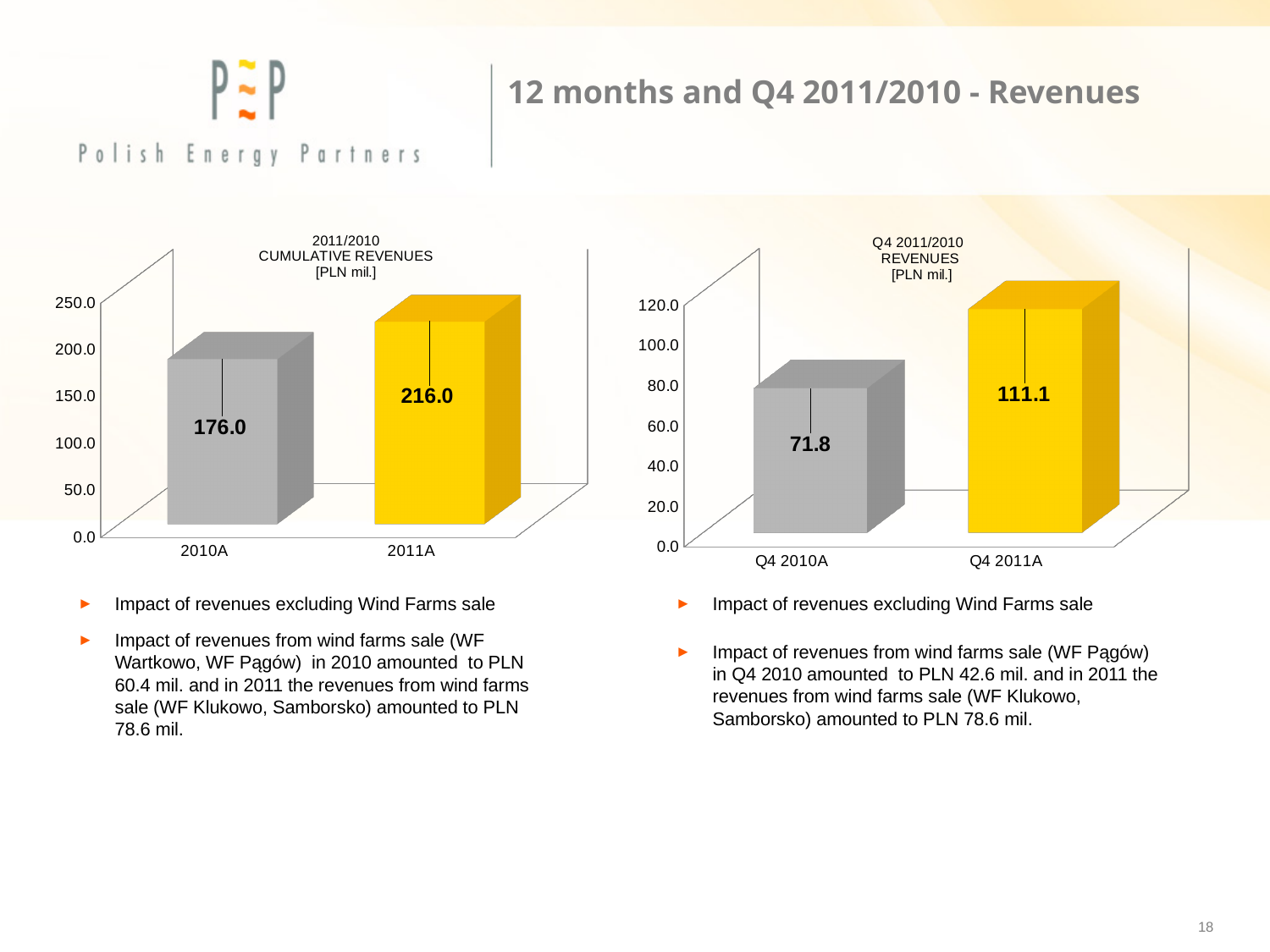
How many categories are shown in the 2011/2010 Cumulative Revenues chart? 2 In the Q4 2011/2010 Revenues chart, what is the value for Q4 2011A? 111.1 In the Q4 2011/2010 Revenues chart, what is the difference between the Q4 2011A and Q4 2010A values? 39.3 In the 2011/2010 Cumulative Revenues chart, what is the difference between the 2011A and 2010A values? 40.0 What kind of chart is the Q4 2011/2010 Revenues chart? bar chart In the 2011/2010 Cumulative Revenues chart, which category has the highest value? 2011A In the 2011/2010 Cumulative Revenues chart, what unit is given in the chart title? PLN mil. In the Q4 2011/2010 Revenues chart, which category has the lowest value? Q4 2010A In the Q4 2011/2010 Revenues chart, what is the value for Q4 2010A? 71.8 In the 2011/2010 Cumulative Revenues chart, what is the value for 2010A? 176.0 In the 2011/2010 Cumulative Revenues chart, what is the value for 2011A? 216.0 In the Q4 2011/2010 Revenues chart, is the value for Q4 2011A greater or less than 100.0? greater